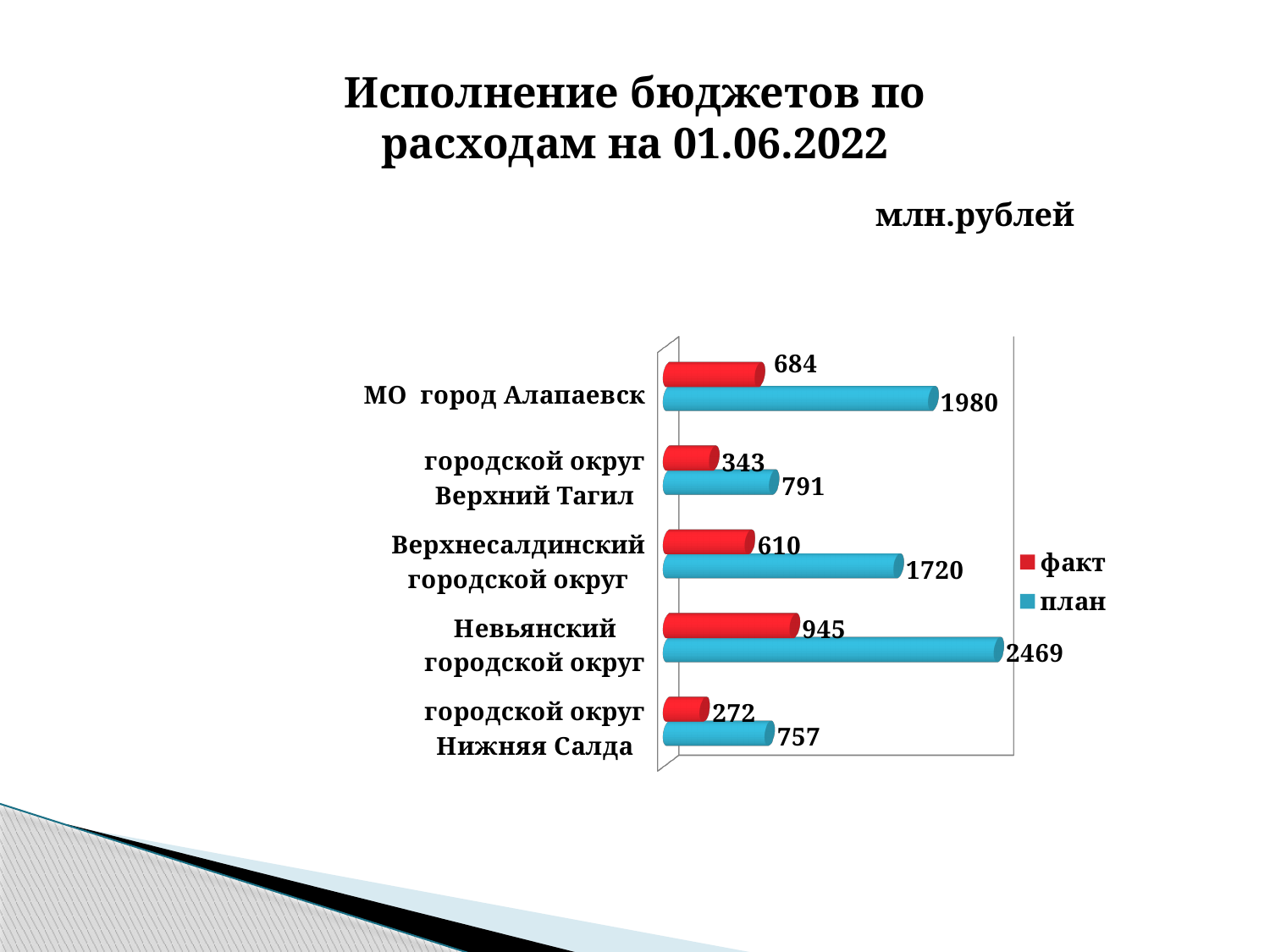
How many categories are shown in the chart? 5 Which category has the lowest факт value? городской округ Нижняя Салда What is the difference between the план and факт values for Верхнесалдинский городской округ? 1110 How many series does the legend list? 2 What is the факт value for городской округ Нижняя Салда? 272 What colour represents the план series? blue What kind of chart is shown on the slide? bar chart What is the факт value for МО город Алапаевск? 684 Which category has the highest план value? Невьянский городской округ Which is larger: the факт value for Невьянский городской округ or the факт value for МО город Алапаевск? Невьянский городской округ What is the план value for Невьянский городской округ? 2469 What is the план value for городской округ Верхний Тагил? 791